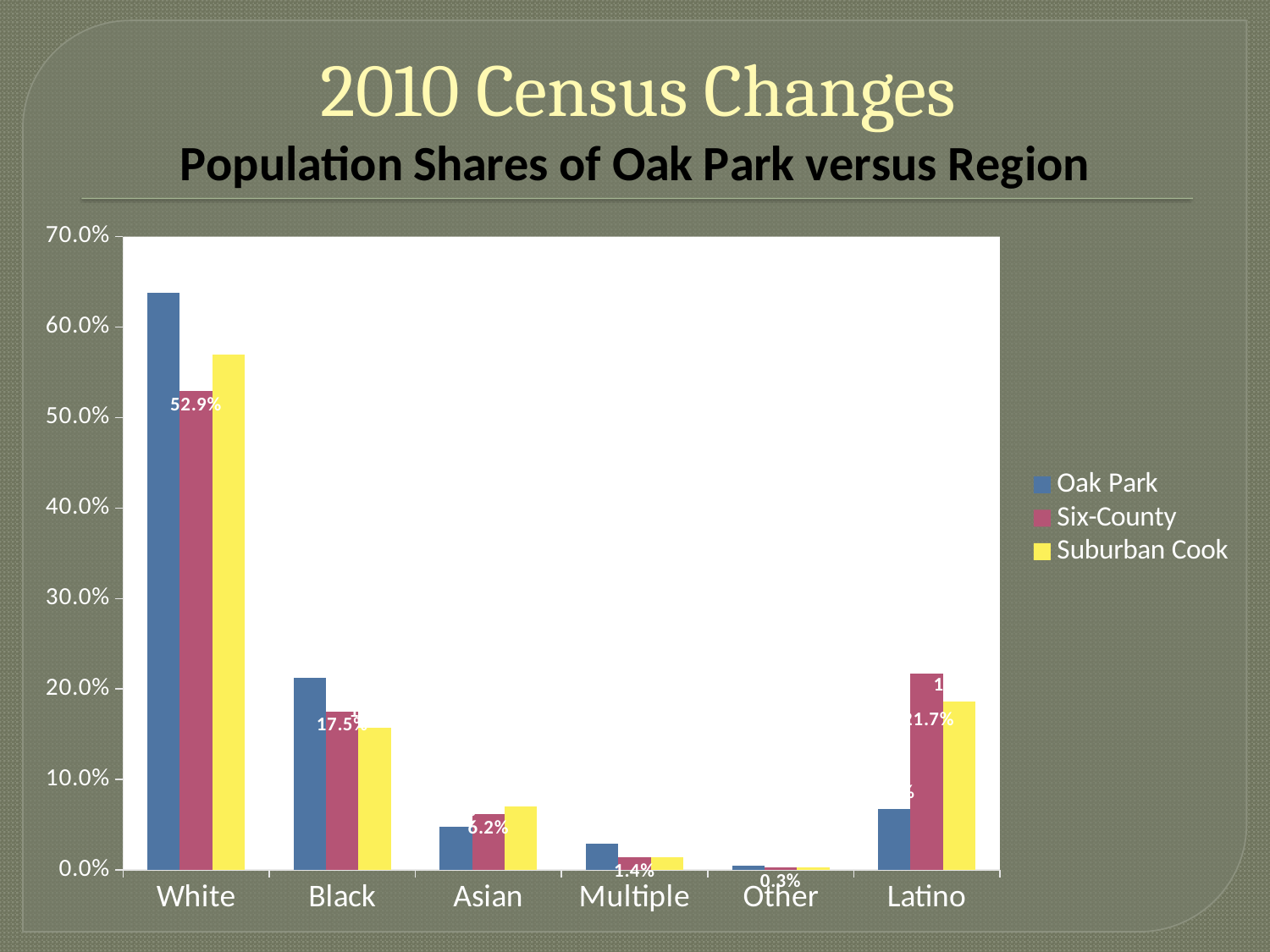
Which is larger for Latino: the Oak Park value or the Six-County value? Six-County How many categories are shown on the x axis? 6 Which category has the highest Oak Park value? White What is the Six-County value for Black? 17.5% What is the Six-County value for Other? 0.3% What is the Six-County value for Latino? 21.7% How many series does the legend list? 3 Is the Oak Park value for White greater or less than 60.0%? greater What is the Six-County value for White? 52.9% What is the difference between the Six-County values for White and Latino? 31.2% What is the subtitle of the chart on the slide? Population Shares of Oak Park versus Region What type of chart is shown on the slide? bar chart